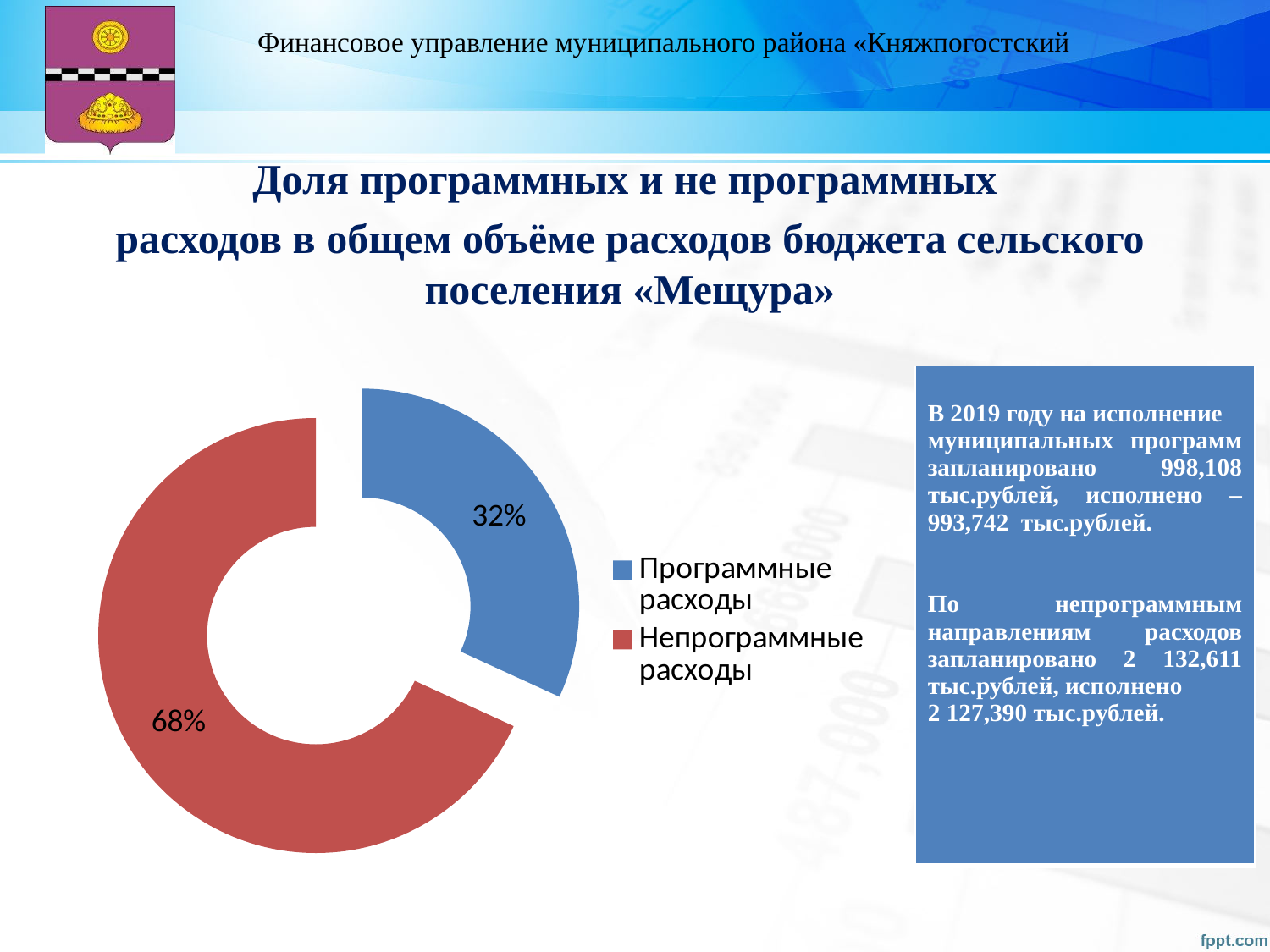
How many categories does the chart show? 2 Which category has the smallest share of the chart? Программные расходы Which category has the largest share of the chart? Непрограммные расходы What share of the chart is labelled for Непрограммные расходы? 68% What colour is the slice for Непрограммные расходы? Red What share of the chart is labelled for Программные расходы? 32% What kind of chart is shown on the slide? Doughnut (pie) chart What is the difference in percentage points between the shares of Непрограммные расходы and Программные расходы? 36 What colour is the slice for Программные расходы? Blue Which is larger: the share of Программные расходы or the share of Непрограммные расходы? Непрограммные расходы How many entries does the legend list? 2